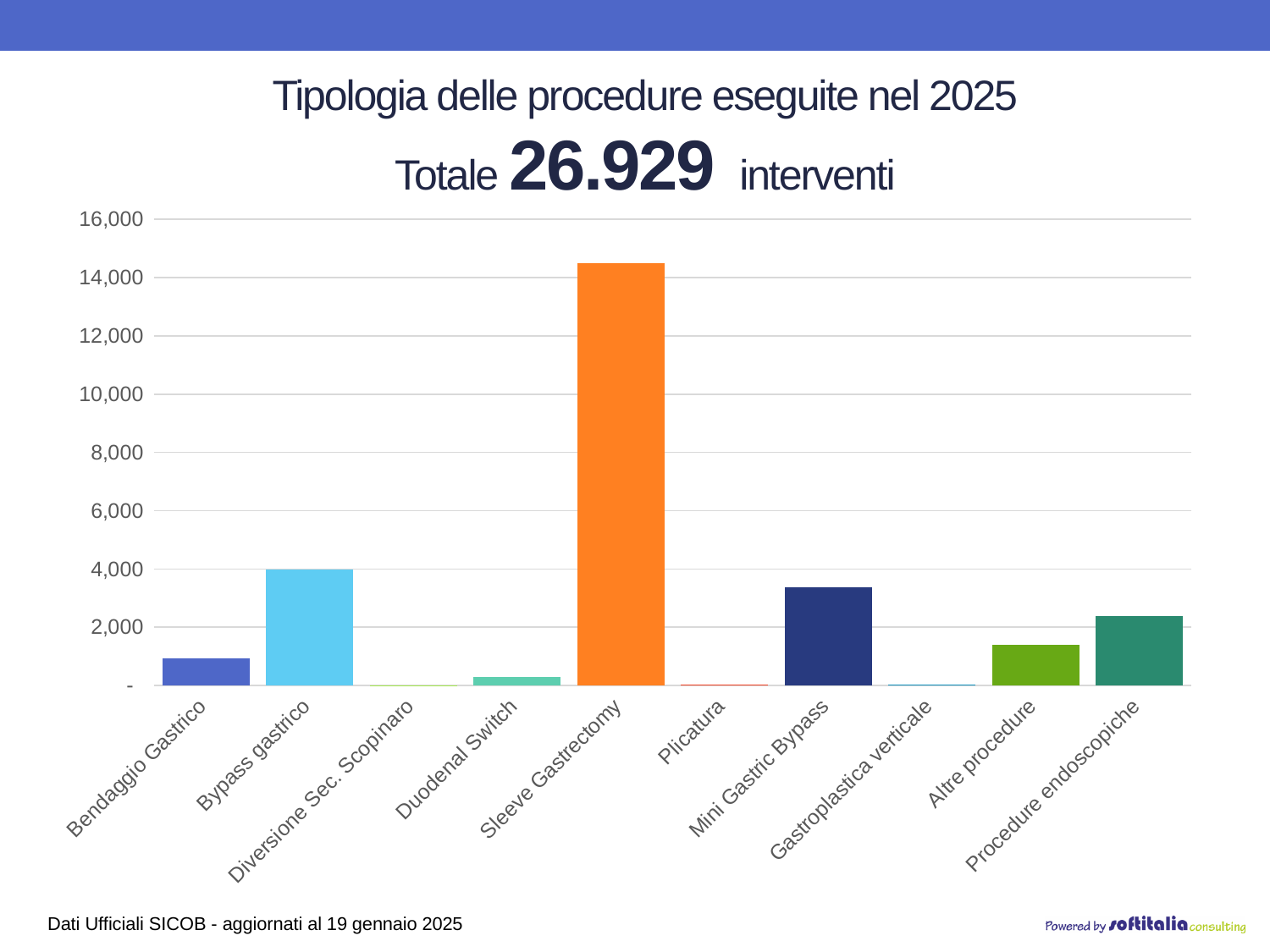
Is the value for Sleeve Gastrectomy greater or less than 14,000? greater Which is larger, the value for Procedure endoscopiche or the value for Bendaggio Gastrico? Procedure endoscopiche Which procedure category has the highest bar? Sleeve Gastrectomy What kind of chart is shown on the slide? bar chart Is the value for Mini Gastric Bypass greater or less than 4,000? less Is the value for Bendaggio Gastrico greater or less than 2,000? less What is the title of the chart? Tipologia delle procedure eseguite nel 2025 Which is larger, the value for Bypass gastrico or the value for Mini Gastric Bypass? Bypass gastrico What total number of interventions is stated in the chart title? 26.929 How many procedure categories are shown on the x axis? 10